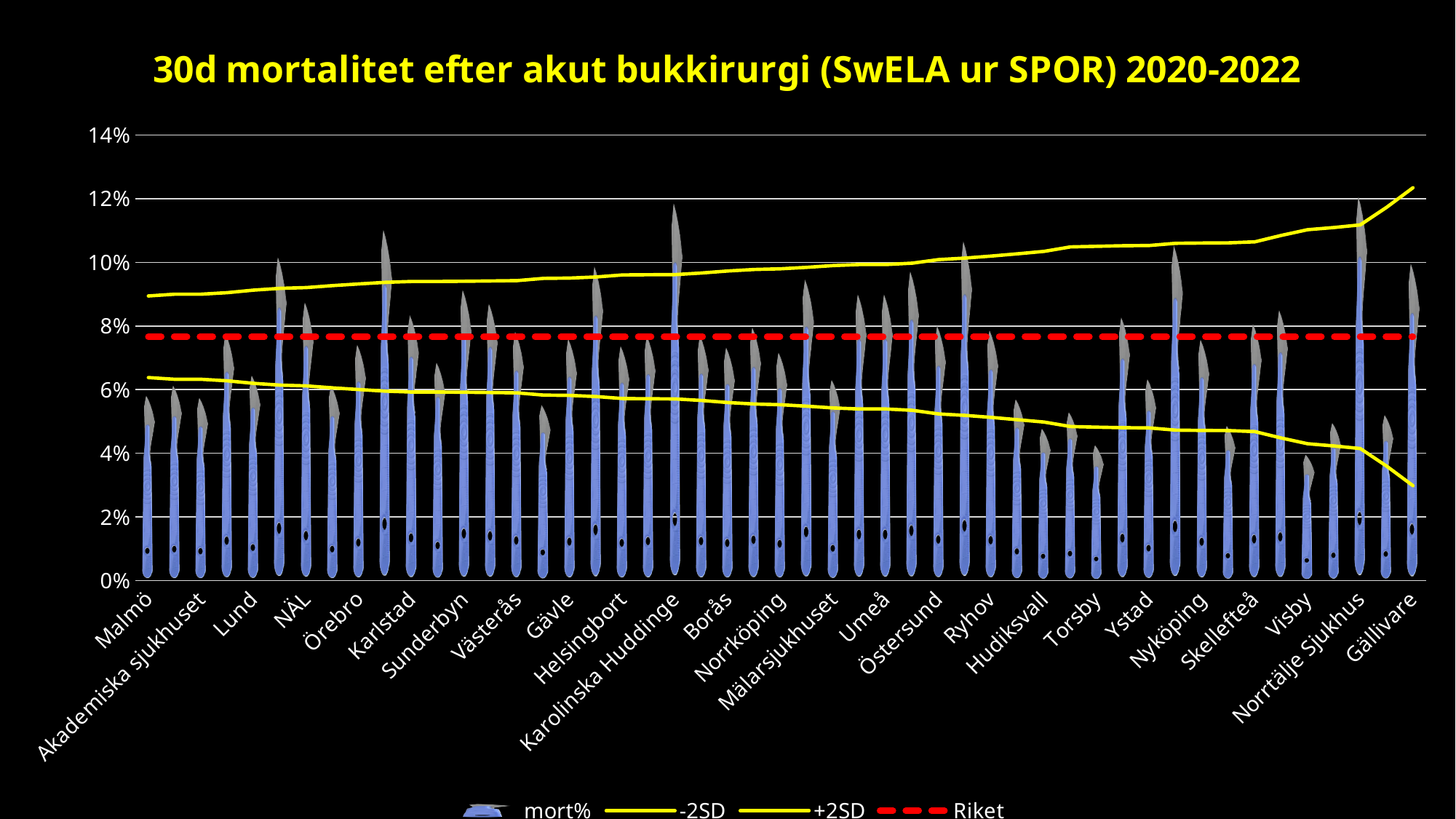
Is the Riket line greater or less than 8%? less Does the +2SD line rise or fall from left to right along the x axis? rise Does the -2SD line rise or fall from left to right along the x axis? fall Which has the larger mort% value, Malmö or Norrtälje Sjukhus? Norrtälje Sjukhus What is the title of the chart? 30d mortalitet efter akut bukkirurgi (SwELA ur SPOR) 2020-2022 Which series is drawn as a red dashed line? Riket Is the mort% value for Gällivare greater or less than 6%? greater Is the mort% value for Norrtälje Sjukhus greater or less than 8%? greater What kind of chart is shown on the slide? bar and line chart Which hospital has the highest mort% bar? Norrtälje Sjukhus How many series does the legend list? 4